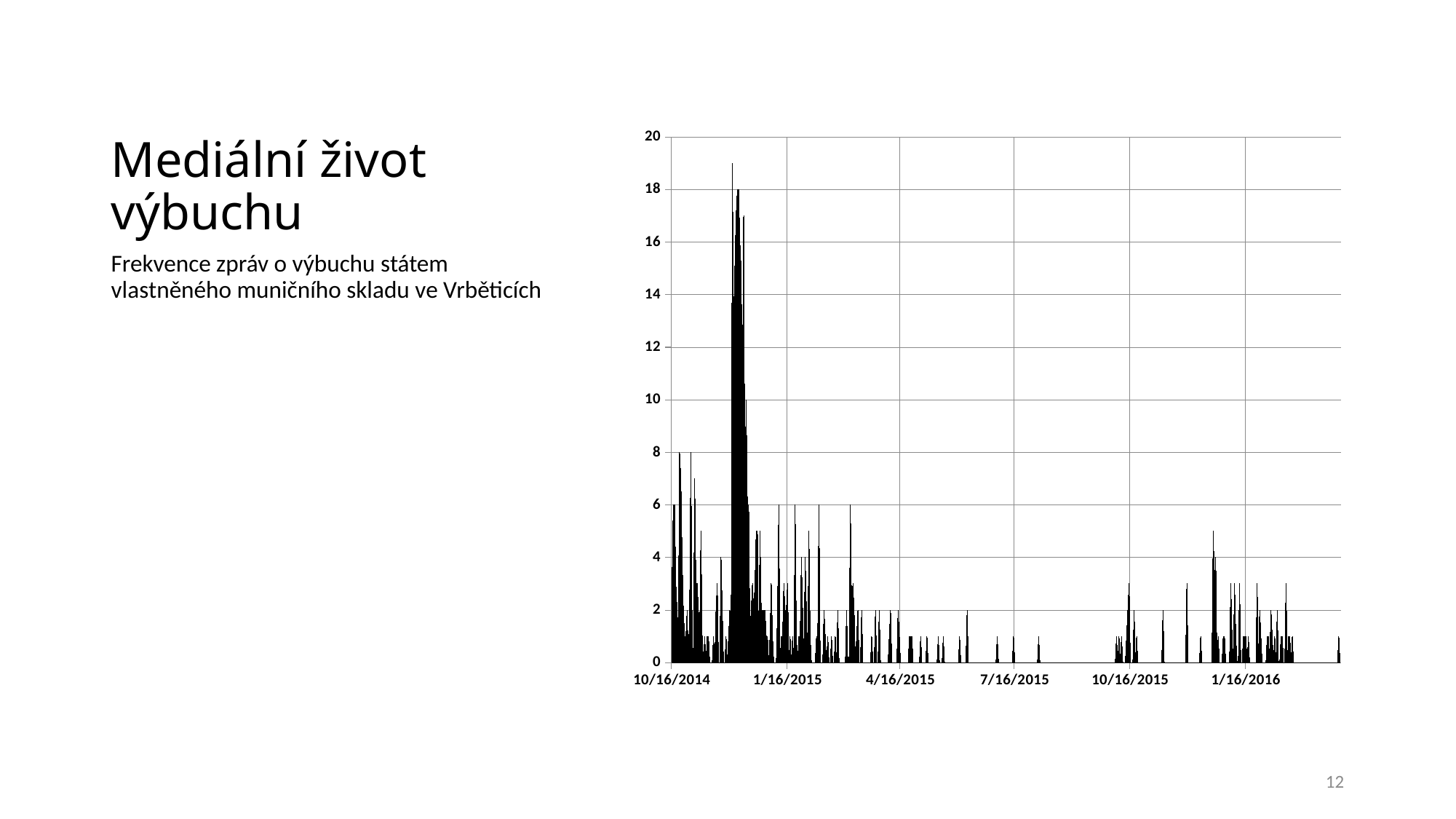
Between which two x-axis labels does the highest peak of the chart occur? 10/16/2014 and 1/16/2015 Is the highest peak in the chart greater or less than 20? less What is the first date label on the x axis of the chart? 10/16/2014 Is the highest value around 1/16/2016 greater or less than 6? less Is the highest value around 7/16/2015 greater or less than 4? less What is the highest value shown on the y axis of the chart? 20 What kind of chart is shown on the slide? bar chart Which period has the higher peak: around 1/16/2015 or around 1/16/2016? around 1/16/2015 Do the values in the chart generally rise or fall from left to right after the main peak? fall How many date labels are shown on the x axis of the chart? 6